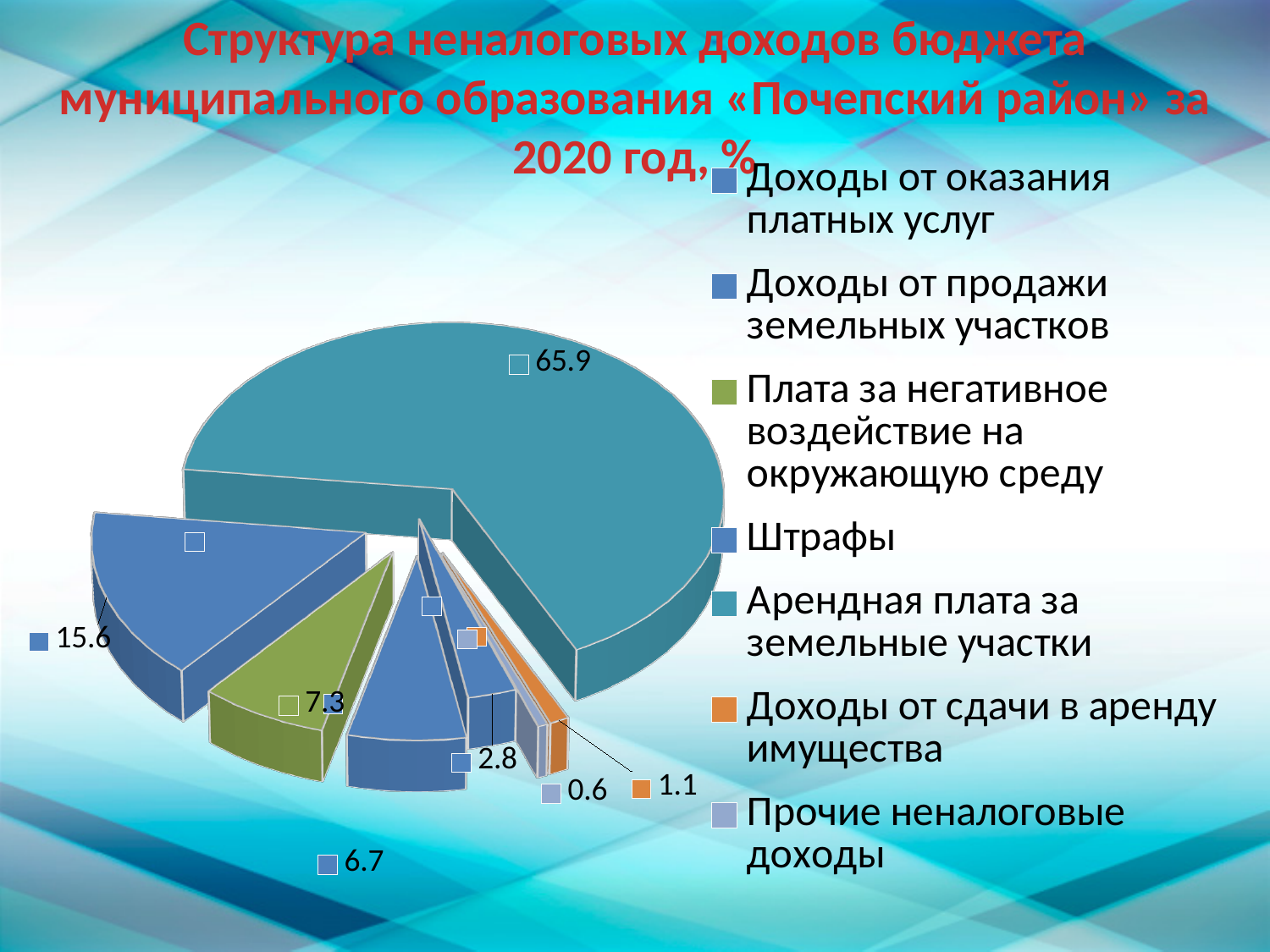
What is the value for «Плата за негативное воздействие на окружающую среду»? 7.3 What is the value for «Арендная плата за земельные участки»? 65.9 Which is larger: «Плата за негативное воздействие на окружающую среду» or «Доходы от сдачи в аренду имущества»? Плата за негативное воздействие на окружающую среду What kind of chart is shown on the slide? Pie chart How many entries does the legend of the pie chart list? 7 What is the difference between the values for «Арендная плата за земельные участки» and «Плата за негативное воздействие на окружающую среду»? 58.6 How many slices does the pie chart have? 7 What is the value for «Доходы от сдачи в аренду имущества»? 1.1 Which category has the smallest slice of the pie? Прочие неналоговые доходы What is the value for «Прочие неналоговые доходы»? 0.6 Which category has the largest slice of the pie? Арендная плата за земельные участки Which year does the chart title say the data is for? 2020